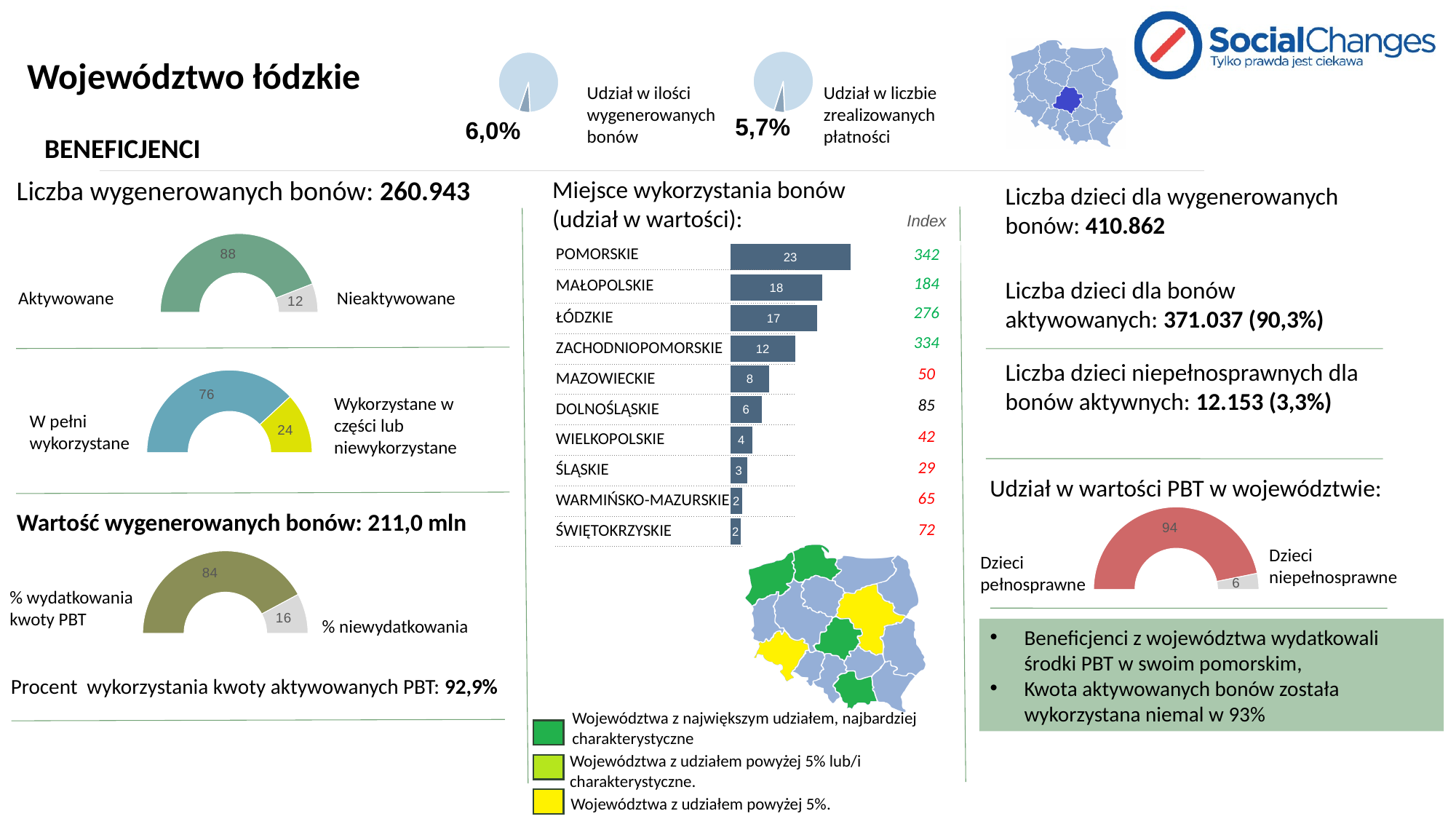
How many voivodeships are listed in the bar chart 'Miejsce wykorzystania bonów (udział w wartości)'? 10 In the half-donut chart with 'Aktywowane' and 'Nieaktywowane', what is the value for Aktywowane? 88 In the bar chart 'Miejsce wykorzystania bonów (udział w wartości)', do the values rise or fall going down the list from POMORSKIE to ŚWIĘTOKRZYSKIE? fall What kind of chart is 'Miejsce wykorzystania bonów (udział w wartości)'? bar chart In the half-donut chart with 'W pełni wykorzystane', what is the value for 'Wykorzystane w części lub niewykorzystane'? 24 In the bar chart 'Miejsce wykorzystania bonów (udział w wartości)', what is the value for POMORSKIE? 23 In the half-donut chart under 'Udział w wartości PBT w województwie', what is the value for 'Dzieci niepełnosprawne'? 6 In the bar chart 'Miejsce wykorzystania bonów (udział w wartości)', which is larger, the value for ZACHODNIOPOMORSKIE or MAZOWIECKIE? ZACHODNIOPOMORSKIE In the bar chart 'Miejsce wykorzystania bonów (udział w wartości)', what is the difference between the values for POMORSKIE and MAŁOPOLSKIE? 5 In the bar chart 'Miejsce wykorzystania bonów (udział w wartości)', what is the value for ŁÓDZKIE? 17 In the small pie chart at the top labelled 'Udział w ilości wygenerowanych bonów', what share is shown? 6,0% In the bar chart 'Miejsce wykorzystania bonów (udział w wartości)', which voivodeship has the highest value? POMORSKIE